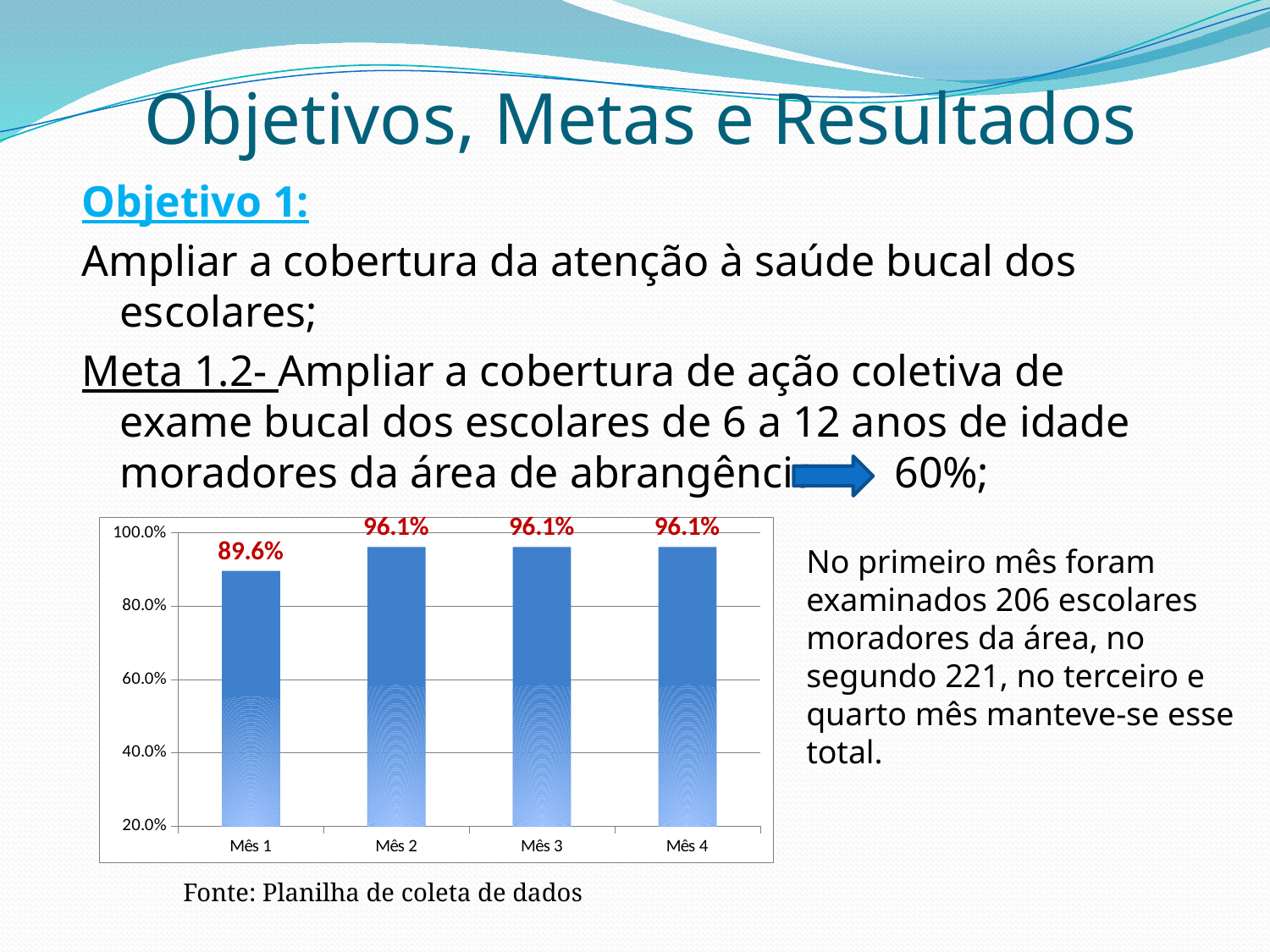
What is the lowest value shown on the y axis? 20.0% What kind of chart is shown on the slide? bar chart Which is larger, the value for Mês 1 or the value for Mês 3? Mês 3 What colour are the bars in the chart? blue Which month has the lowest value? Mês 1 What is the value for Mês 2? 96.1% What is the value for Mês 1? 89.6% What is the difference between the values for Mês 2 and Mês 1? 6.5% What is the value for Mês 4? 96.1% How many months are shown on the x axis? 4 Do the values rise or fall from Mês 1 to Mês 2? rise Is the value for Mês 1 greater or less than 80.0%? greater